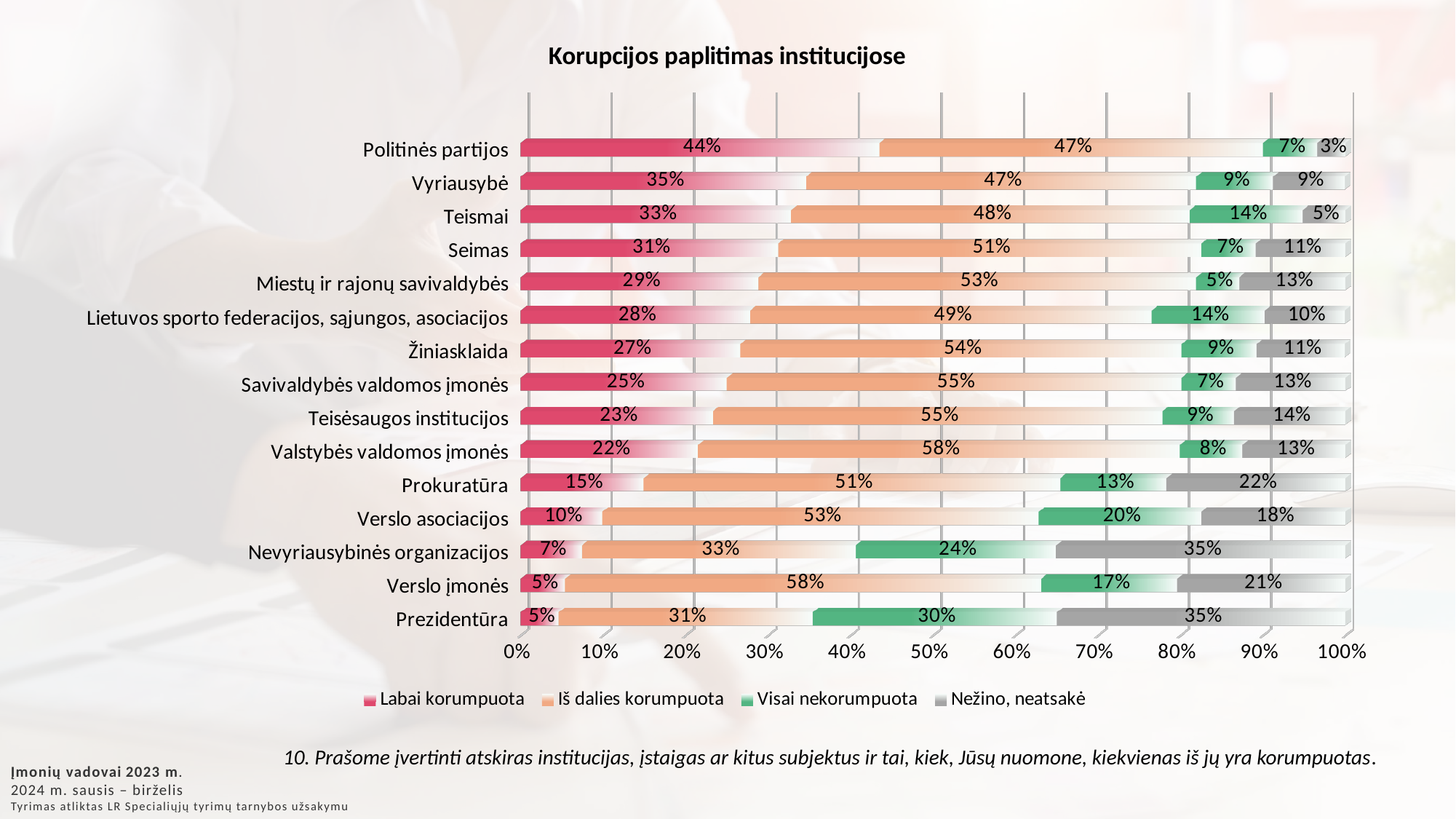
What type of chart is shown on the slide? Stacked bar chart What is the 'Nežino, neatsakė' value for Prokuratūra? 22% How many series does the legend list? 4 How many institutions (categories) are shown in the chart? 15 Which institution has the highest 'Visai nekorumpuota' value? Prezidentūra What is the difference between the 'Labai korumpuota' values for Vyriausybė and Seimas? 4% Which institution has the highest 'Labai korumpuota' value? Politinės partijos What is the 'Iš dalies korumpuota' value for Valstybės valdomos įmonės? 58% What is the title of the chart? Korupcijos paplitimas institucijose Which has a larger 'Visai nekorumpuota' value, Verslo asociacijos or Teismai? Verslo asociacijos What is the 'Labai korumpuota' value for Politinės partijos? 44% Which institution has the lowest 'Nežino, neatsakė' value? Politinės partijos